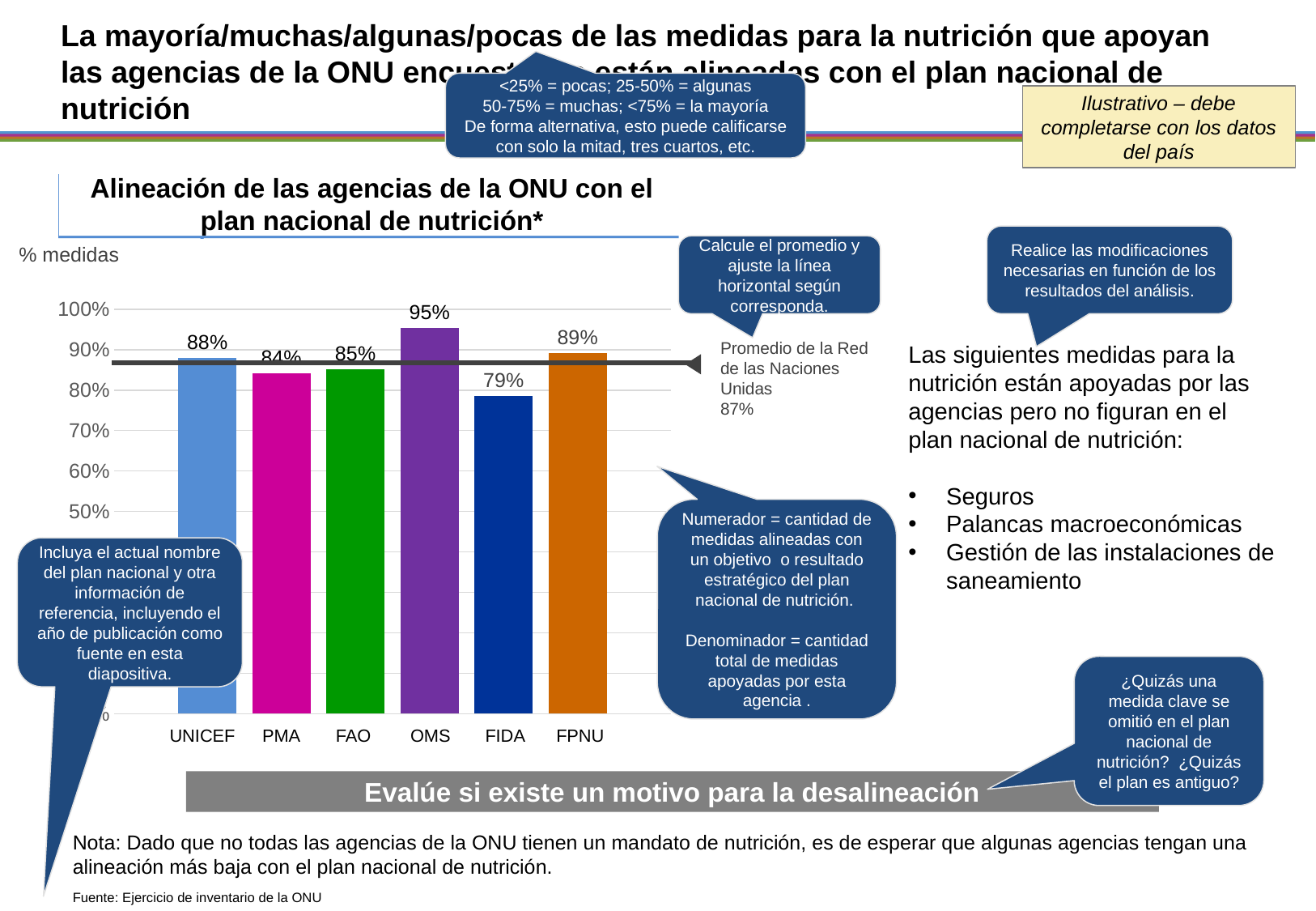
What is the value for OMS? 95% What value is given for the 'Promedio de la Red de las Naciones Unidas' horizontal line? 87% Which is larger, the value for UNICEF or the value for PMA? UNICEF Is the value for FIDA greater or less than 80%? less What kind of chart is shown? bar chart What is the difference between the values for OMS and FIDA? 16% Which agency has the highest value? OMS What is the value for FPNU? 89% What is the value for FIDA? 79% Which agency has the lowest value? FIDA What is the value for UNICEF? 88% How many agencies are shown on the x axis? 6